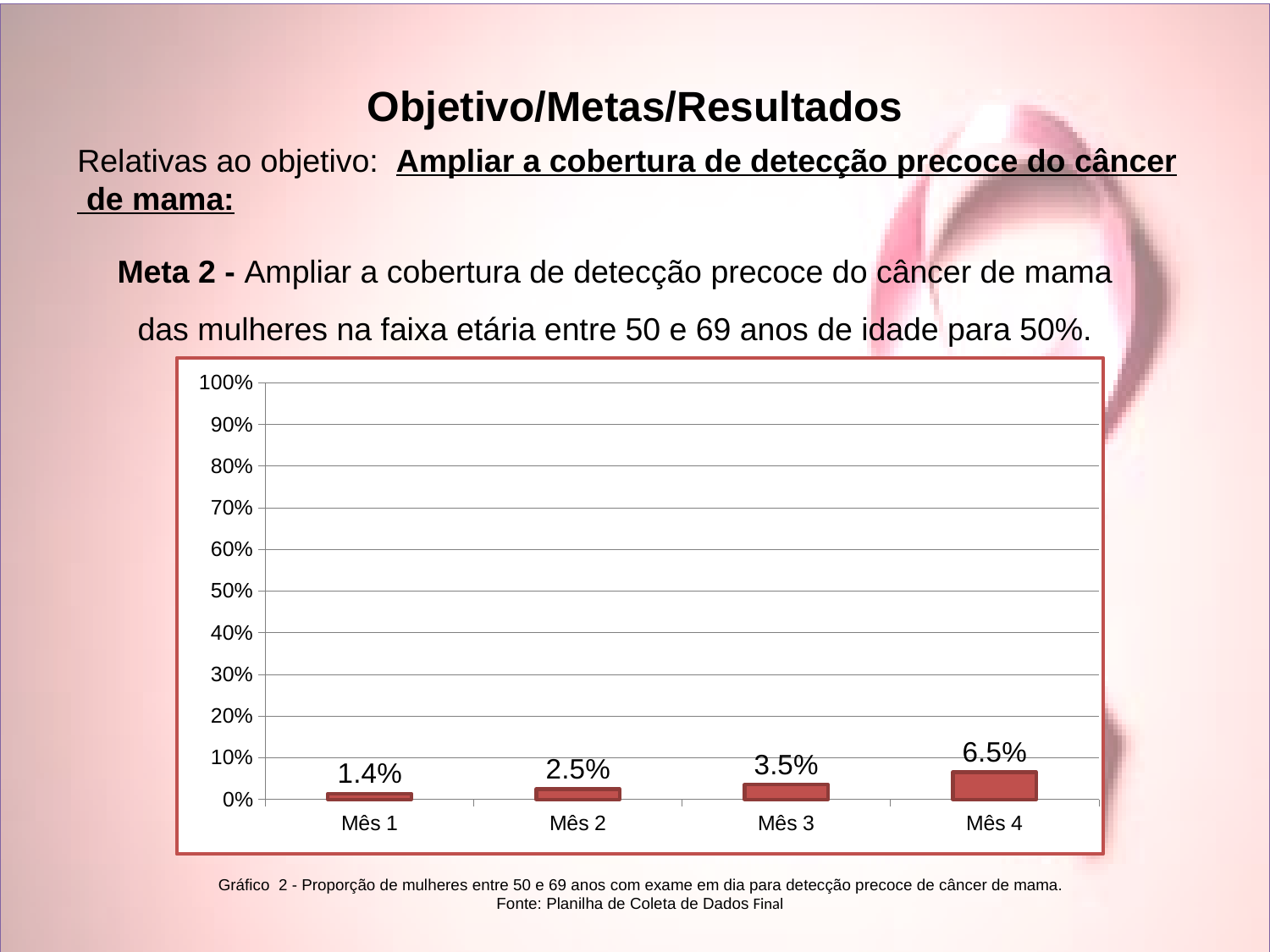
What kind of chart is shown on the slide? bar chart Which month has the lowest value? Mês 1 Which month has the highest value? Mês 4 What is the value for Mês 3? 3.5% How many months are shown on the x axis? 4 Is the value for Mês 4 greater or less than 10%? less What is the value for Mês 4? 6.5% What is the difference between the values for Mês 4 and Mês 1? 5.1% Which is larger, the value for Mês 2 or the value for Mês 3? Mês 3 What is the value for Mês 2? 2.5% What is the value for Mês 1? 1.4% What is the difference between the values for Mês 3 and Mês 2? 1.0%